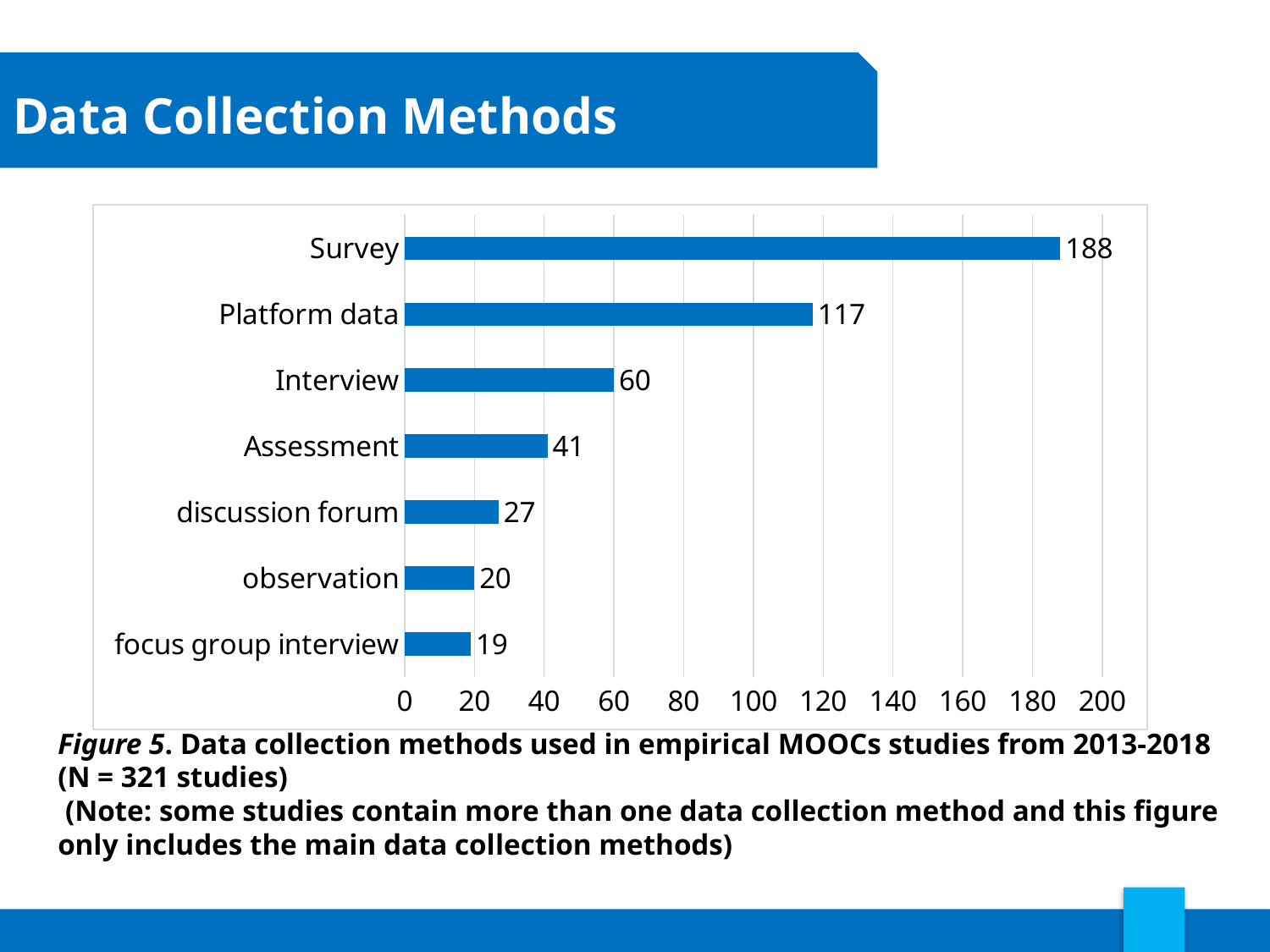
How many data collection methods are shown in the chart? 7 Which data collection method has the highest value? Survey What is the value for focus group interview? 19 Which is larger, the value for Interview or the value for Assessment? Interview What is the difference between the values for Interview and Assessment? 19 What is the difference between the values for Survey and Platform data? 71 What is the value for Survey? 188 What is the value for Platform data? 117 What is the value for discussion forum? 27 Which data collection method has the lowest value? focus group interview What kind of chart is shown on the slide? bar chart What is the highest value shown on the horizontal axis? 200